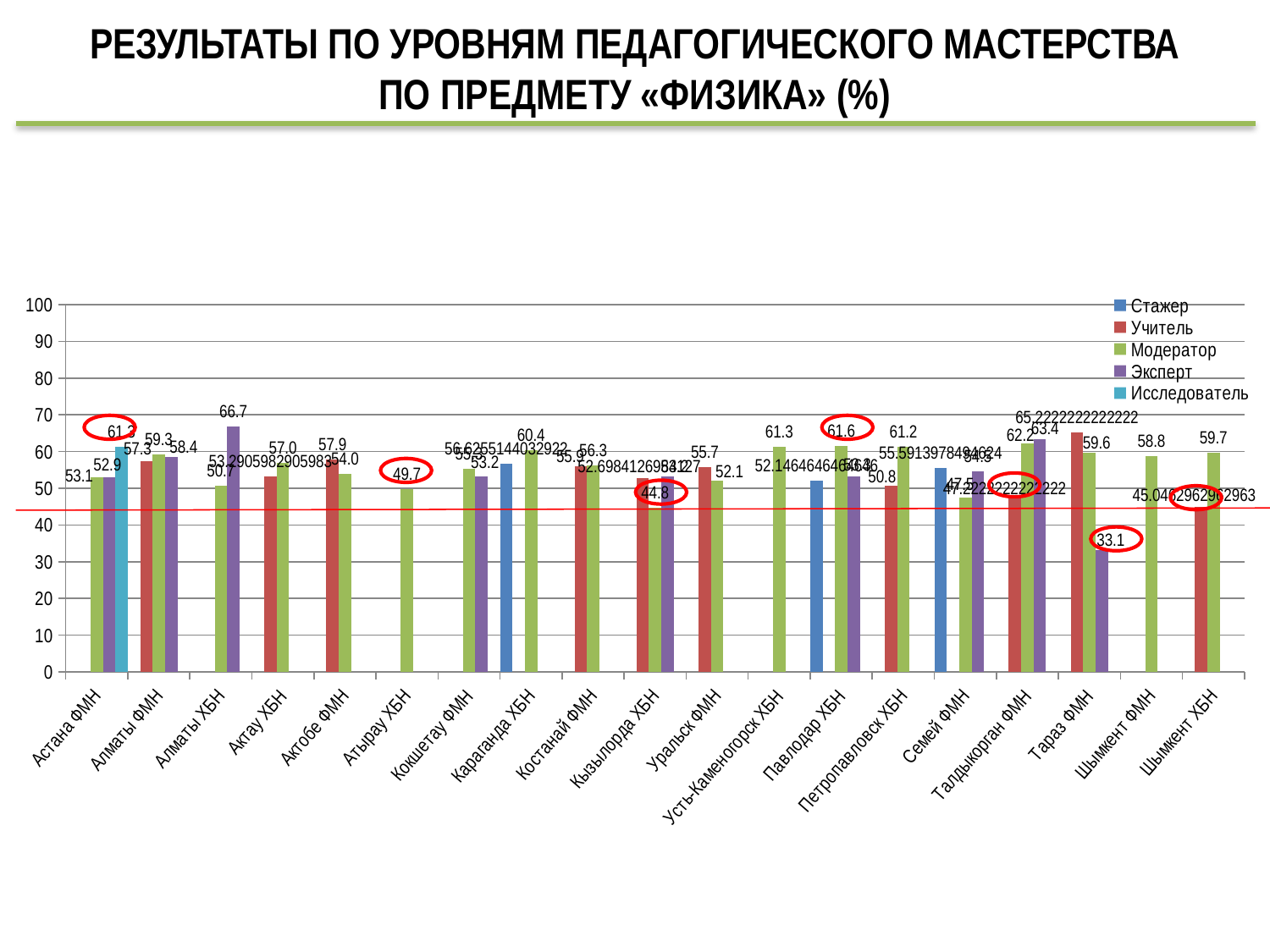
What is the value for Модератор in Атырау ХБН? 49.7 What is the value for Эксперт in Алматы ХБН? 66.7 How many categories (cities) are shown along the x axis? 19 In Актобе ФМН, which is larger: Учитель or Модератор? Учитель How many series does the legend list? 5 Which bar has the lowest value on the whole chart? Эксперт in Тараз ФМН (33.1) What is the difference between the Модератор and Учитель values for Алматы ФМН? 2.0 Which category has the highest Эксперт value? Алматы ХБН What is the value for Эксперт in Тараз ФМН? 33.1 What is the value for Исследователь in Астана ФМН? 61.3 Is the value for Стажер in Семей ФМН greater or less than 50? greater What kind of chart is shown on the slide? bar chart